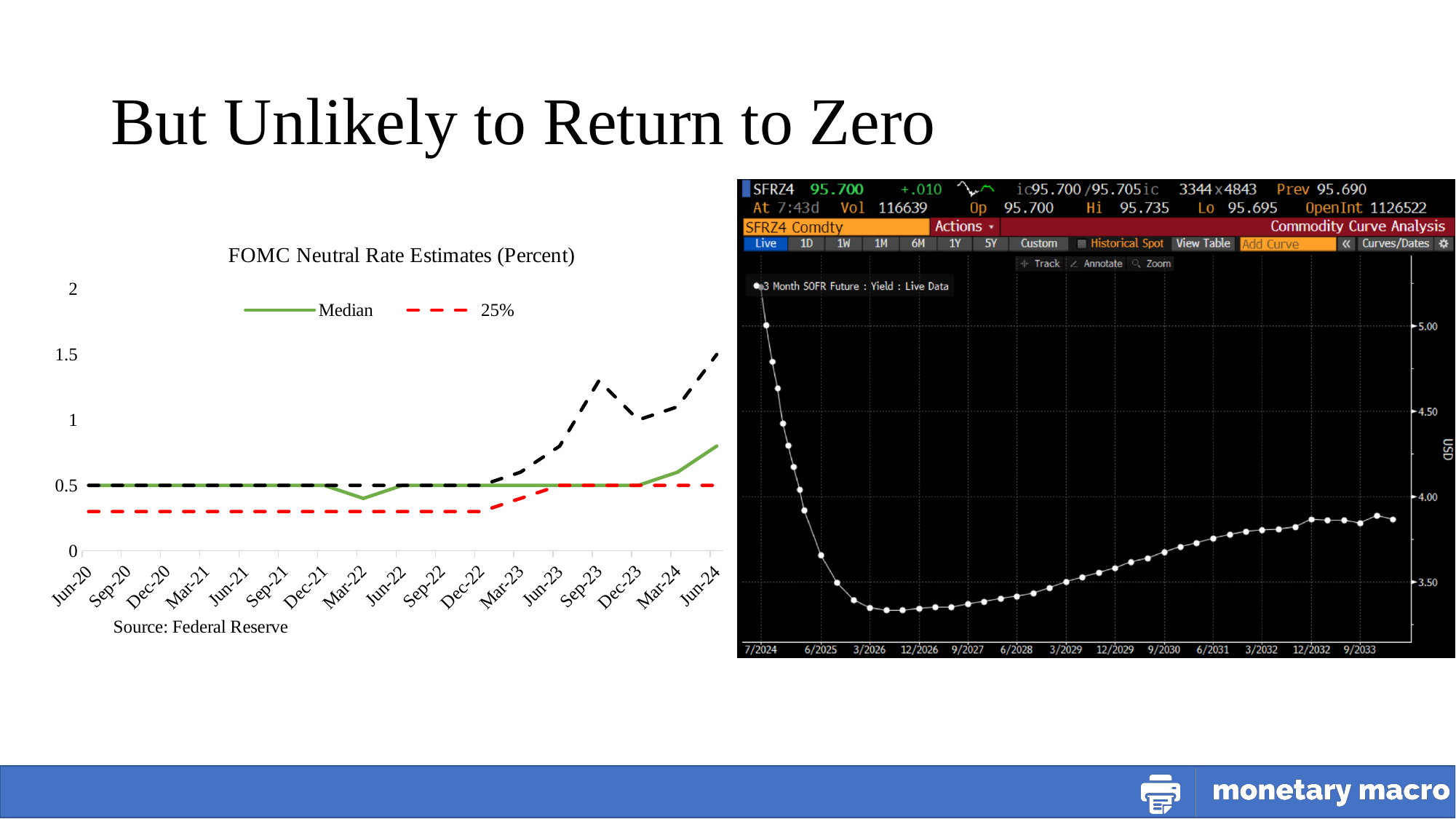
In the FOMC Neutral Rate Estimates chart, is the Median value at Jun-24 greater or less than 0.5? greater How many dates are labelled on the x axis of the FOMC Neutral Rate Estimates chart? 17 In the Bloomberg SOFR futures chart on the right, is the yield at 12/2026 greater or less than 3.50? less In the FOMC Neutral Rate Estimates chart, is the 25% value at Jun-20 greater or less than 0.5? less In the FOMC Neutral Rate Estimates chart, which series is higher at Jun-24, Median or 25%? Median What kind of chart is the FOMC Neutral Rate Estimates chart on the left? line chart How many series does the legend of the FOMC Neutral Rate Estimates chart list? 2 In the FOMC Neutral Rate Estimates chart, does the Median series rise or fall between Dec-23 and Jun-24? rise What are the two series named in the legend of the FOMC Neutral Rate Estimates chart? Median and 25% What is the source cited below the FOMC Neutral Rate Estimates chart? Federal Reserve